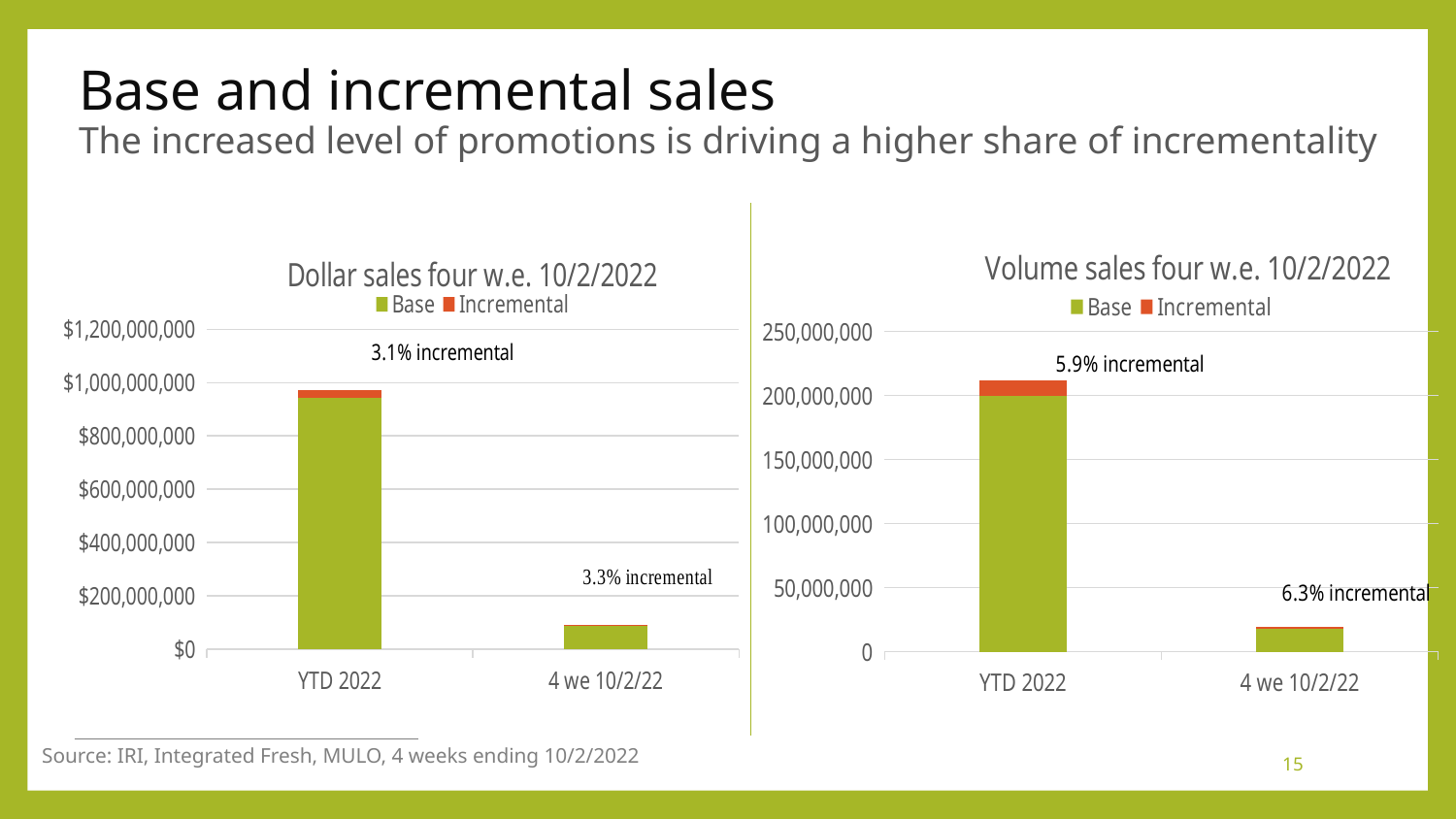
In the "Volume sales four w.e. 10/2/2022" chart, what incremental share is labelled for 4 we 10/2/22? 6.3% incremental In the "Dollar sales four w.e. 10/2/2022" chart, is the total bar for YTD 2022 greater or less than $800,000,000? greater What kind of chart is the "Dollar sales four w.e. 10/2/2022" chart? Stacked bar chart How many categories are shown on the x axis of the "Dollar sales four w.e. 10/2/2022" chart? 2 In the "Volume sales four w.e. 10/2/2022" chart, what incremental share is labelled above the YTD 2022 bar? 5.9% incremental In the "Dollar sales four w.e. 10/2/2022" chart, which category has the taller stacked bar? YTD 2022 How many series does the legend of the "Volume sales four w.e. 10/2/2022" chart list? 2 In the "Volume sales four w.e. 10/2/2022" chart, is the total bar for YTD 2022 greater or less than 150,000,000? greater In the "Volume sales four w.e. 10/2/2022" chart, which series is shown in orange? Incremental In the "Dollar sales four w.e. 10/2/2022" chart, what incremental share is labelled above the YTD 2022 bar? 3.1% incremental In the "Dollar sales four w.e. 10/2/2022" chart, is the total bar for 4 we 10/2/22 greater or less than $200,000,000? less In the "Dollar sales four w.e. 10/2/2022" chart, what incremental share is labelled for 4 we 10/2/22? 3.3% incremental